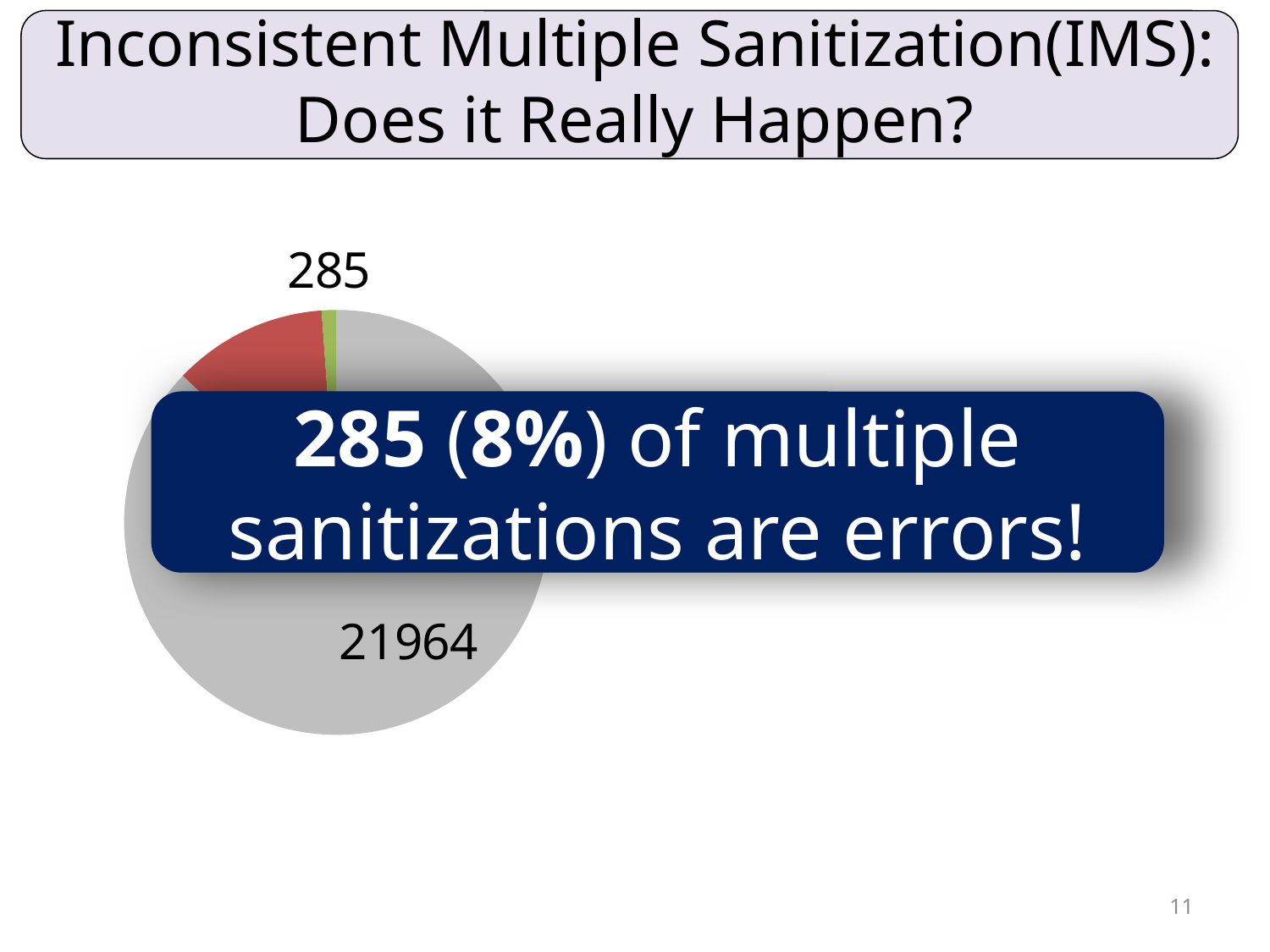
Which is larger, the value 21964 or the value 285? 21964 What is the difference between the two labelled values, 21964 and 285? 21679 According to the callout on the slide, what percentage of multiple sanitizations are errors? 8% What colour is the largest slice of the pie chart? gray What is the smaller value labelled on the pie chart? 285 What value is labelled on the large gray slice of the pie chart? 21964 What kind of chart is shown on the slide? pie chart How many slices does the pie chart have? 3 What is the title of the slide containing the pie chart? Inconsistent Multiple Sanitization(IMS): Does it Really Happen? Which labelled value on the pie chart is the largest? 21964